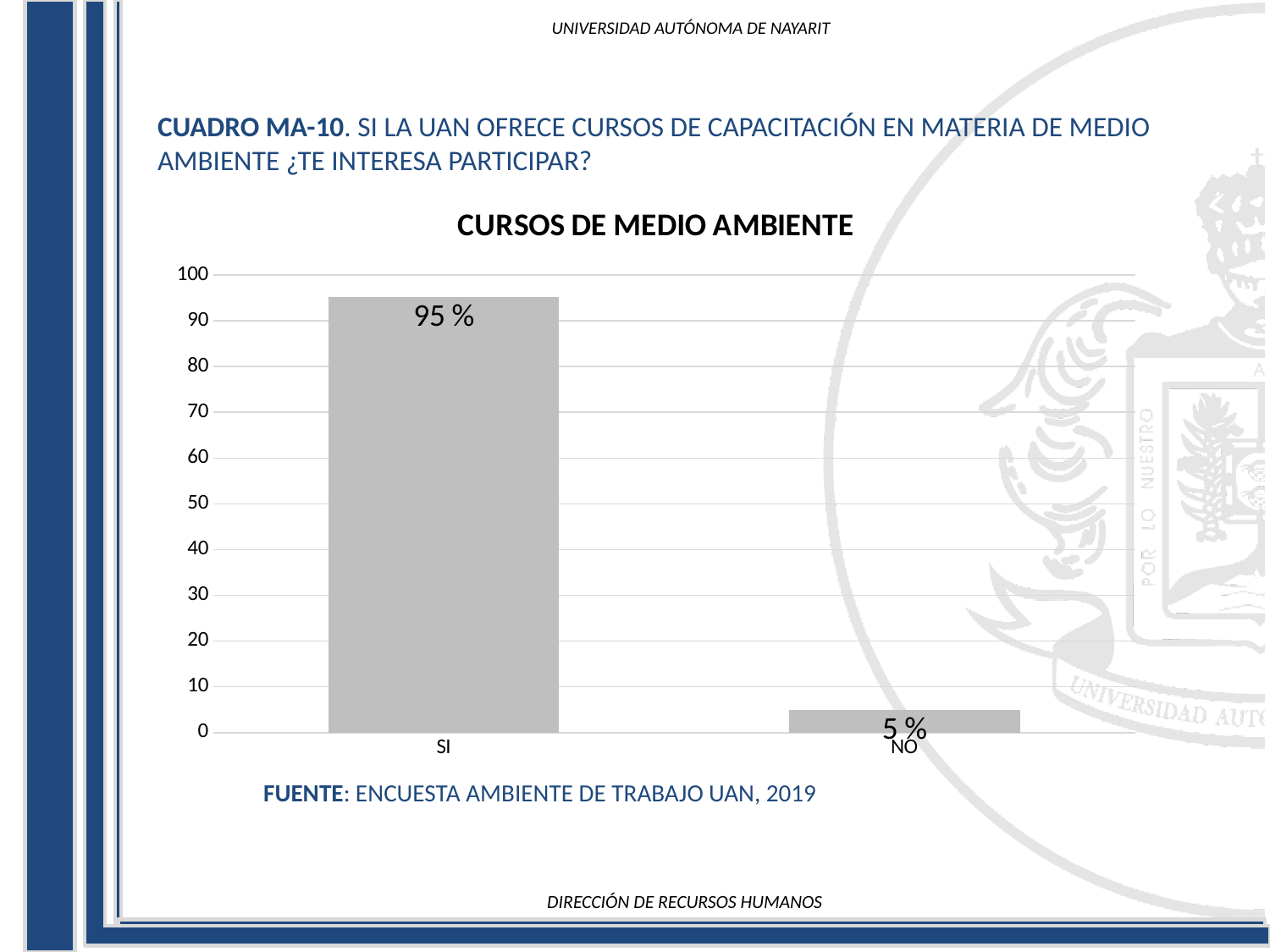
Is the value for SI greater or less than 50? greater Which category has the lowest value? NO Which category has the highest value? SI How many categories are shown on the x axis? 2 What is the value for SI? 95 % What is the maximum value shown on the y axis? 100 What kind of chart is shown on the slide? bar chart Which is larger, the value for SI or the value for NO? SI Is the value for NO greater or less than 10? less What is the title of the chart? CURSOS DE MEDIO AMBIENTE What is the value for NO? 5 % What is the difference between the values for SI and NO? 90 %